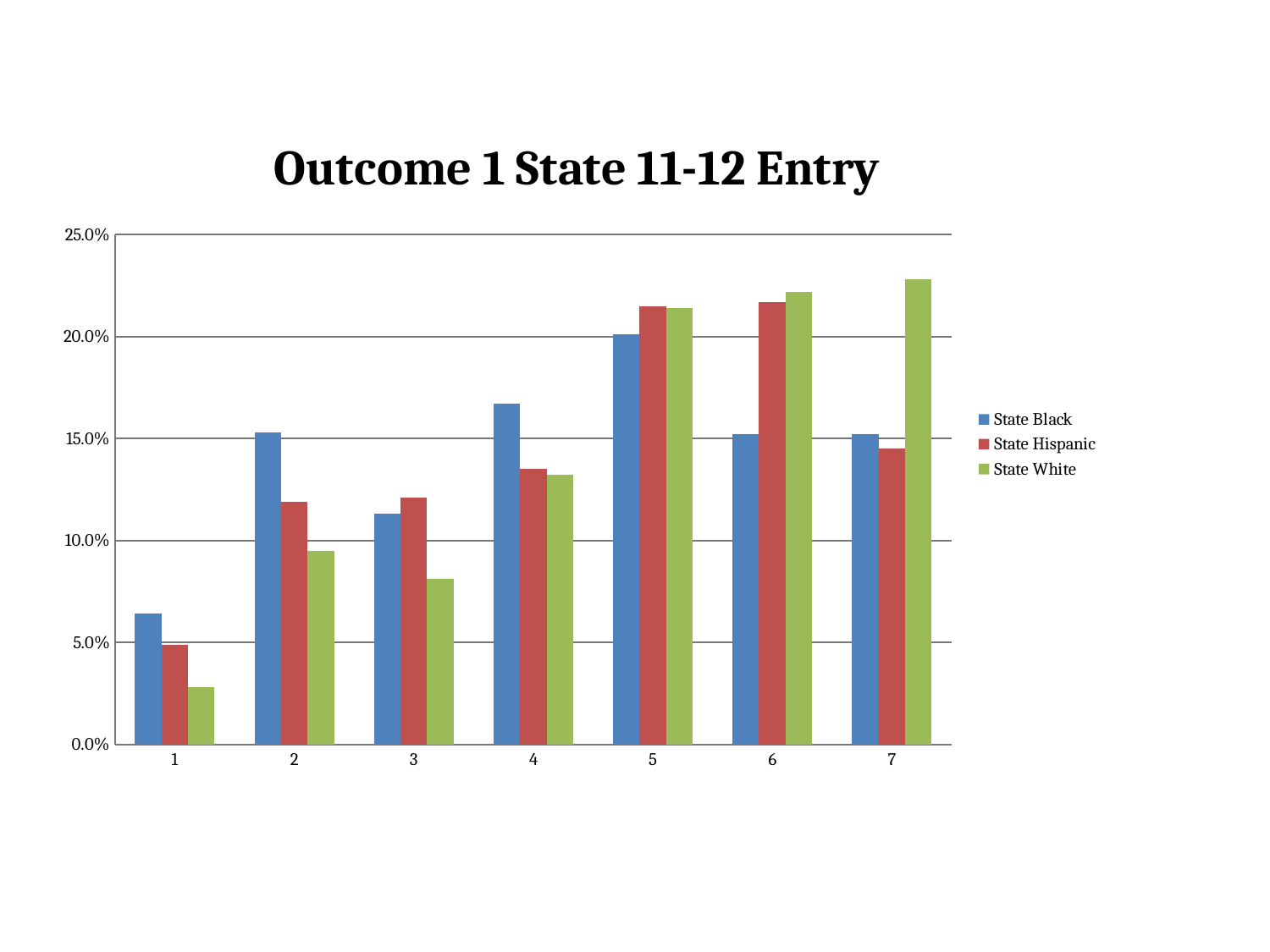
For category 7, which is larger: State White or State Black? State White Is the State Black value for category 4 greater or less than 15.0%? greater What is the title of the chart? Outcome 1 State 11-12 Entry For which category is the State Black value highest? 5 Is the State White value for category 1 greater or less than 5.0%? less What kind of chart is shown on the slide? Bar chart For which category is the State White value highest? 7 Is the State Hispanic value for category 6 greater or less than 20.0%? greater Which colour represents State White in the legend? Green How many categories are shown along the x axis? 7 How many series does the legend list? 3 For which category is the State White value lowest? 1